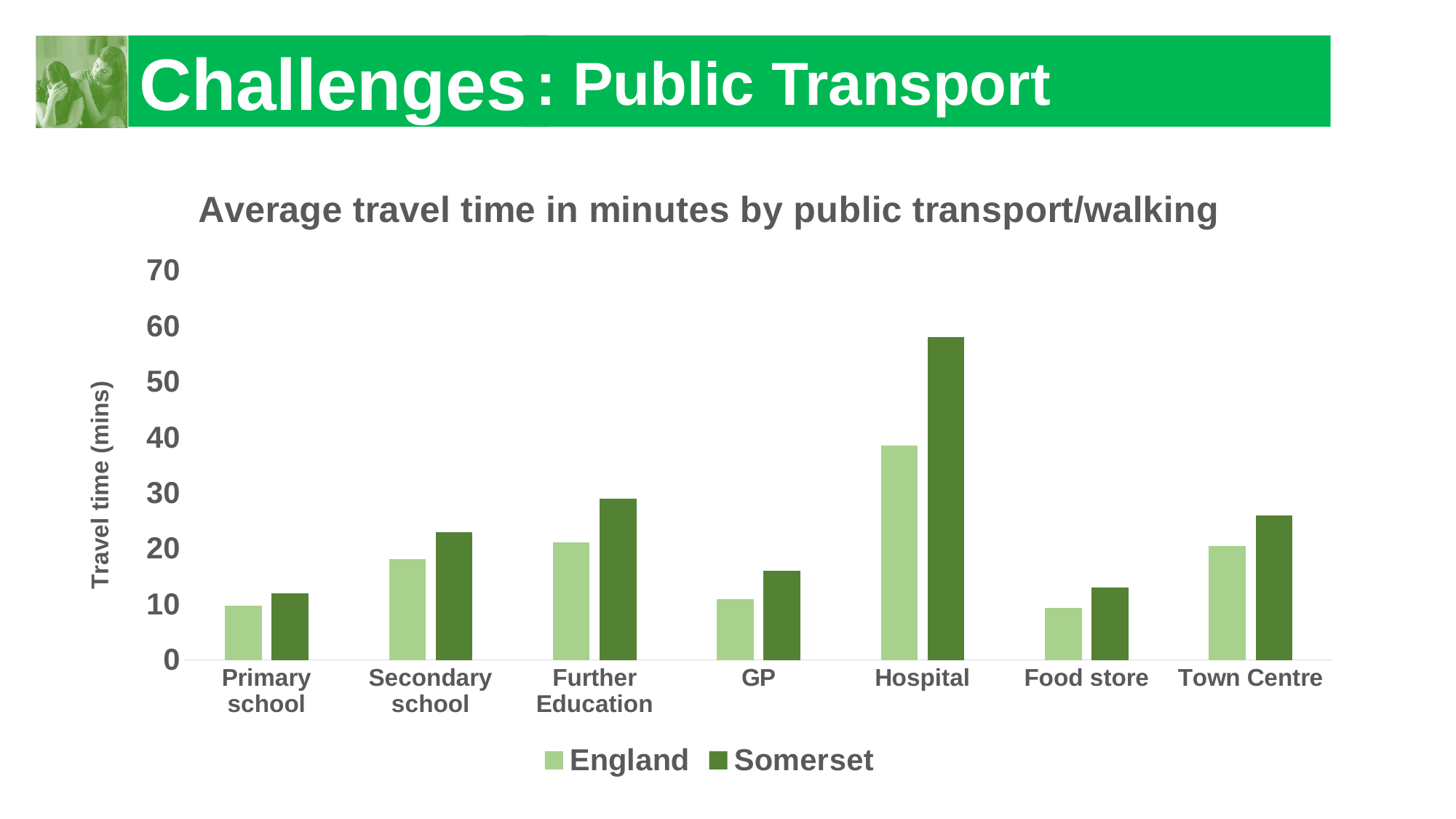
What is the title of the chart? Average travel time in minutes by public transport/walking Is the Somerset value for Primary school greater or less than 20? less How many series does the legend list? 2 What is the label on the vertical axis? Travel time (mins) Which destination has the highest average travel time for Somerset? Hospital Is the Somerset value for Hospital greater or less than 50? greater Which destination has the highest average travel time for England? Hospital Is the Somerset value for Further Education greater or less than 20? greater How many destination categories are shown on the x axis? 7 For Hospital, which is larger: the England value or the Somerset value? Somerset What kind of chart is shown on the slide? bar chart